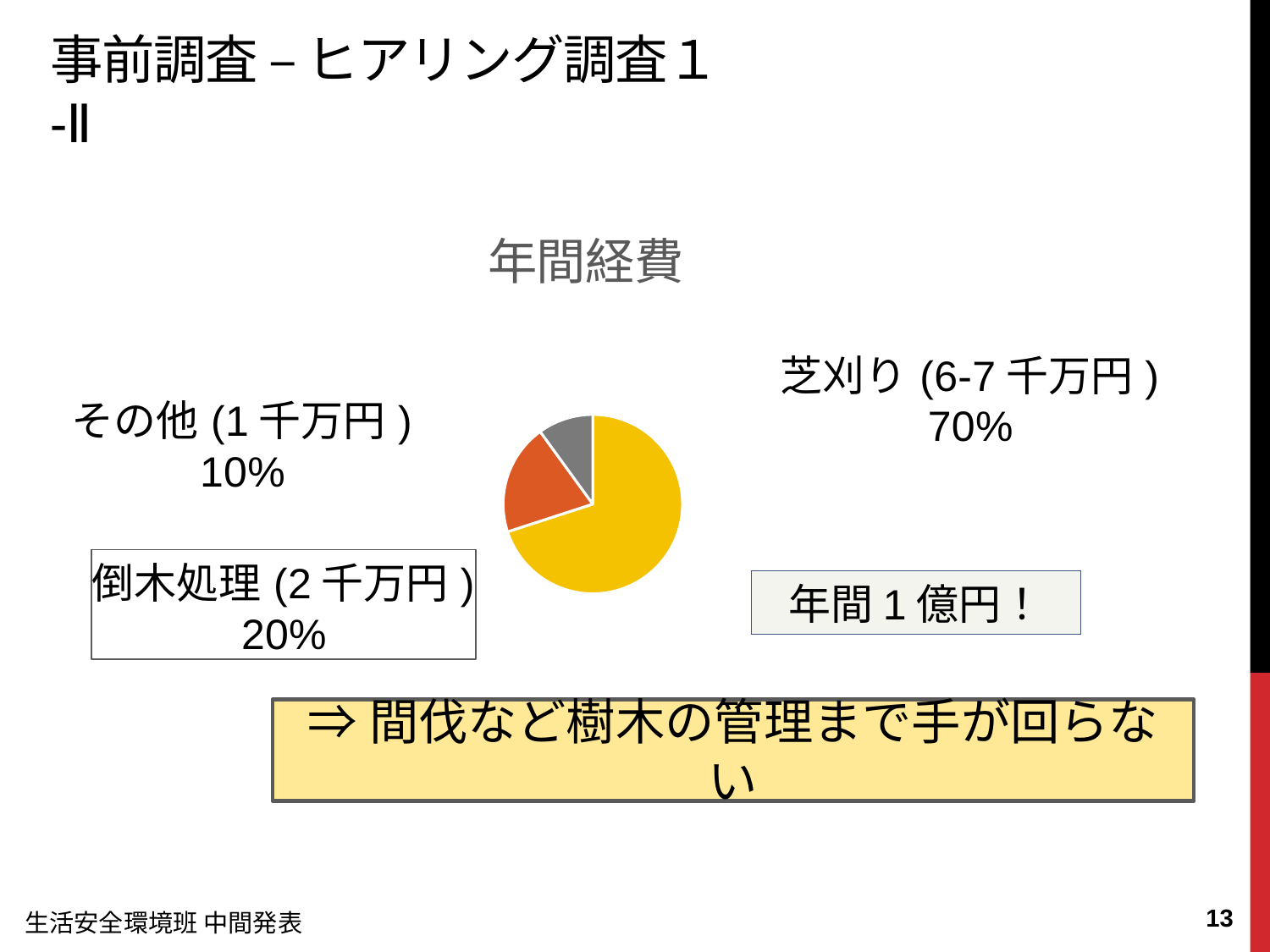
What share of the pie does 倒木処理 account for? 20% What is the difference in percentage points between the 芝刈り share and the 倒木処理 share? 50 What amount is shown in parentheses next to 倒木処理? 2 千万円 What colour is the 芝刈り slice of the pie? yellow Which category has the smallest share of the pie? その他 How many slices does the pie chart have? 3 What is the title of the chart? 年間経費 Which category has the largest share of the pie? 芝刈り What type of chart is shown on the slide? pie chart Which has a larger share, 倒木処理 or その他? 倒木処理 What share of the pie does 芝刈り account for? 70% What share of the pie does その他 account for? 10%